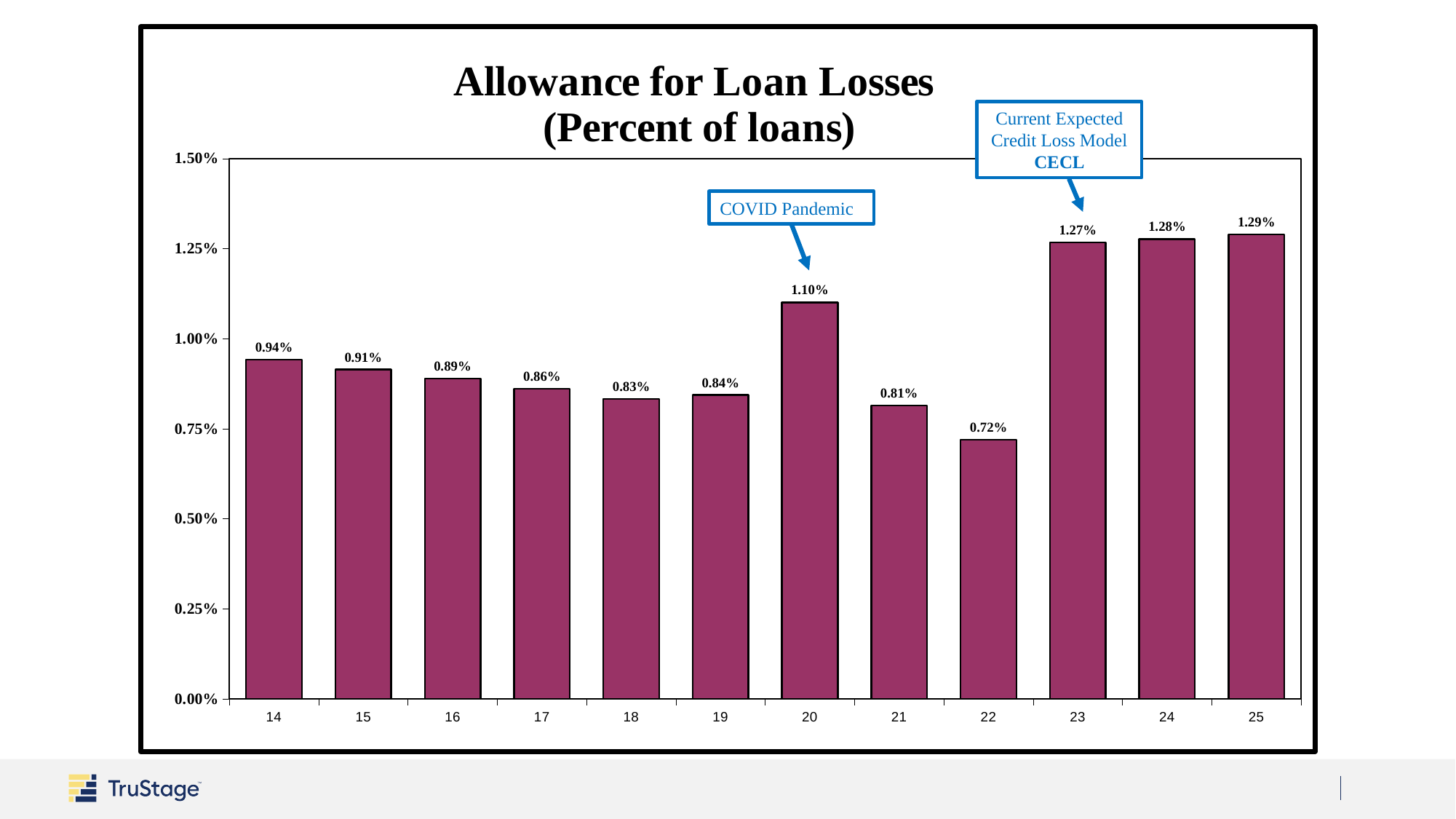
What is the value shown for 22? 0.72% What is the value shown for 14? 0.94% Which year has the highest allowance for loan losses? 25 Which is larger, the value for 15 or the value for 21? 15 Do the values rise or fall from 14 to 18? fall What kind of chart is shown on the slide? bar chart What is the allowance for loan losses value for 20? 1.10% Which year is labelled with the 'COVID Pandemic' callout? 20 How many years are shown on the x axis? 12 Is the value for 18 greater or less than 1.00%? less What is the difference between the values for 23 and 22? 0.55% Which year has the lowest allowance for loan losses? 22